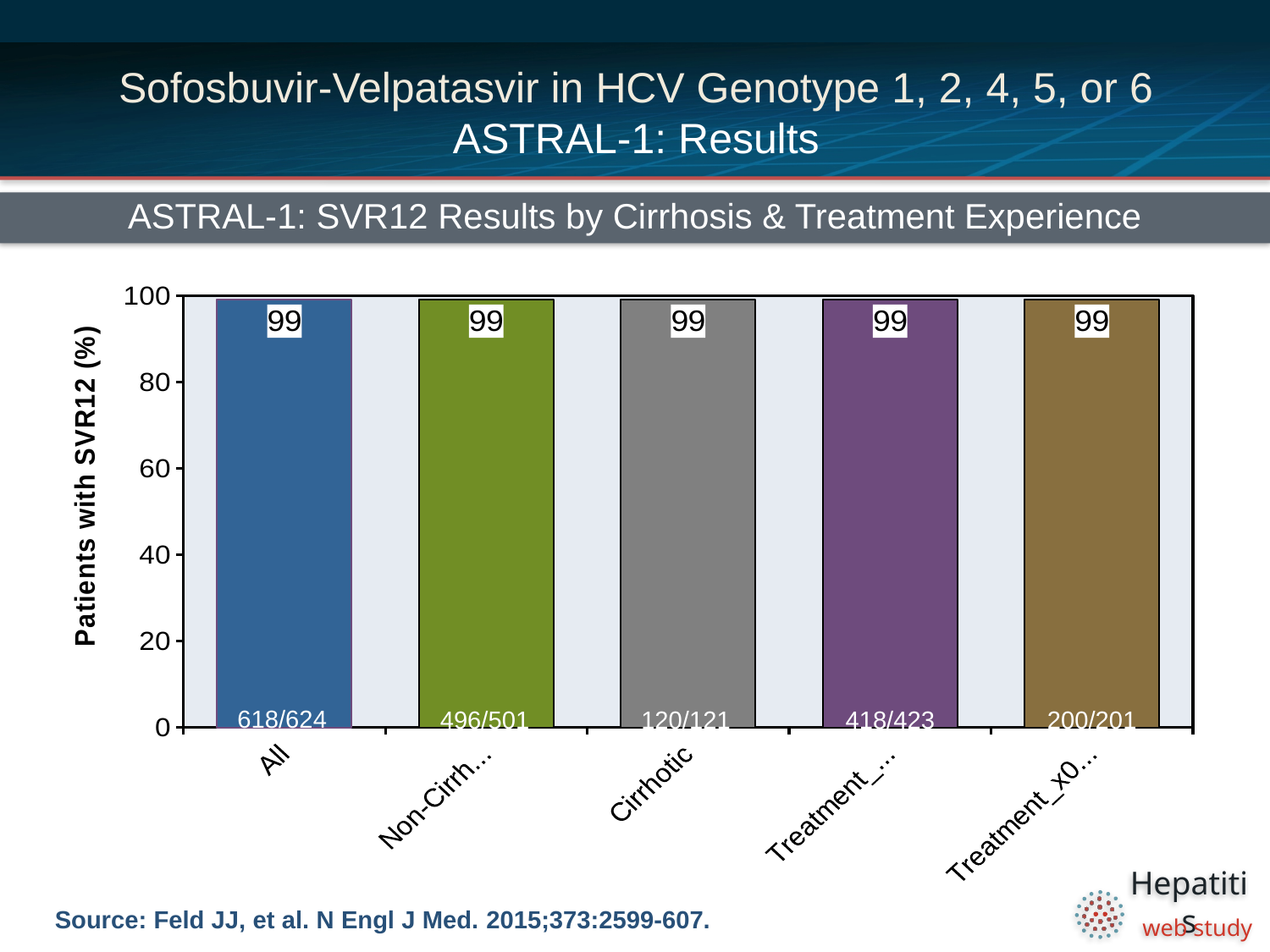
What patient fraction is printed at the base of the All bar? 618/624 What is the SVR12 value shown for the All group? 99 What is the difference between the SVR12 values for the All group and the Cirrhotic group? 0 What kind of chart is shown on the slide? bar chart What is the SVR12 value shown for the Cirrhotic group? 99 Do the bar values rise, fall, or stay flat from left to right across the chart? stay flat What is the title of the chart? ASTRAL-1: SVR12 Results by Cirrhosis & Treatment Experience How many bars are plotted in the chart? 5 What patient fraction is printed at the base of the Cirrhotic bar? 120/121 What is the label of the y-axis? Patients with SVR12 (%) Is the value for the All group greater or less than 80? greater What patient fraction is printed at the base of the rightmost bar? 200/201